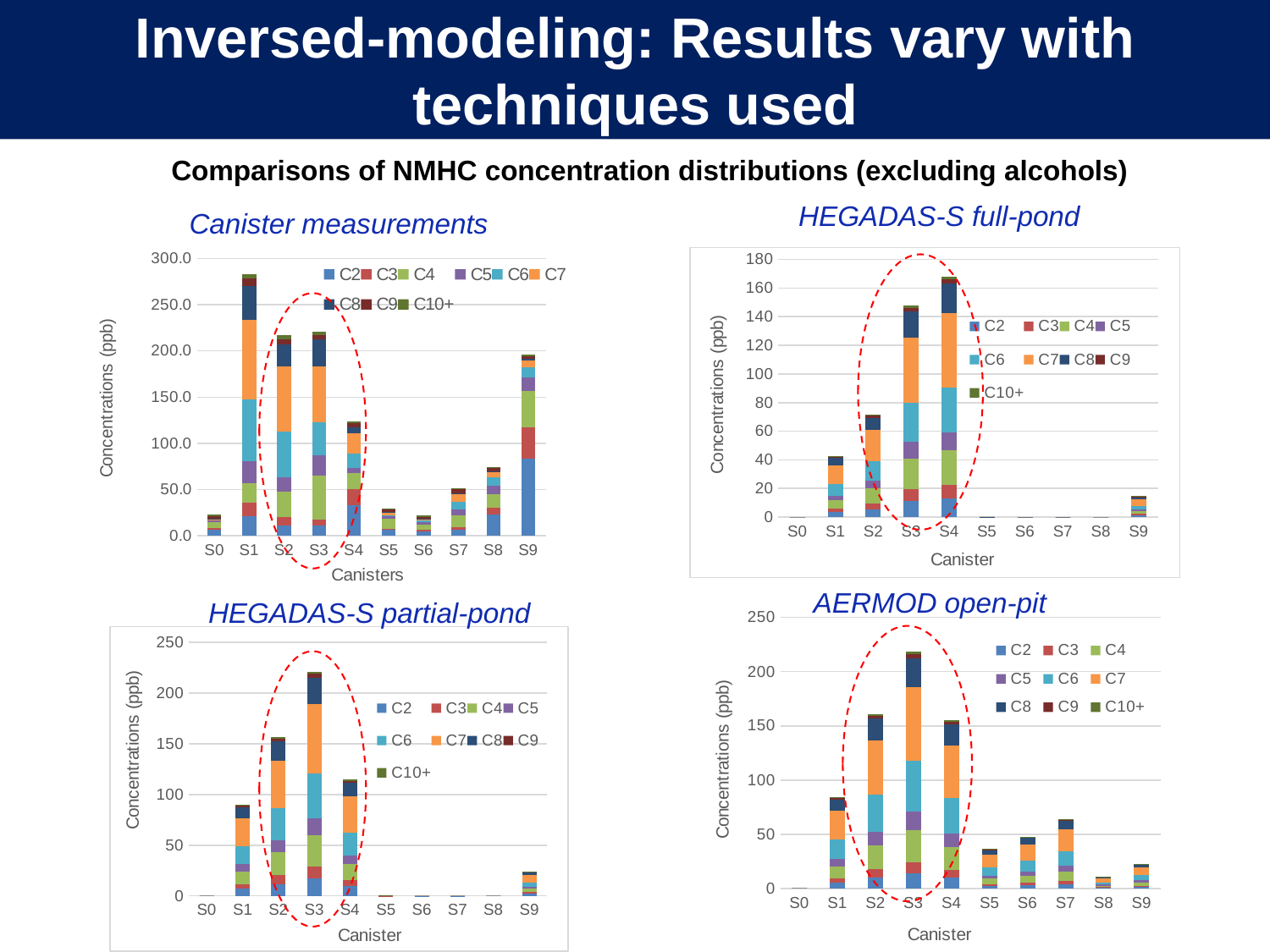
In the Canister measurements chart, what kind of chart is used? Stacked bar chart In the HEGADAS-S full-pond chart, which canister has the highest total concentration? S4 In the Canister measurements chart, how many canister categories are shown on the x axis? 10 In the HEGADAS-S partial-pond chart, is the total value for S1 greater or less than 100? less In the Canister measurements chart, which canister has the highest total concentration? S1 In the HEGADAS-S full-pond chart, is the total value for S9 greater or less than 20? less In the HEGADAS-S partial-pond chart, which canister has the highest total concentration? S3 In the Canister measurements chart, is the total value for S9 greater or less than 150? greater In the HEGADAS-S full-pond chart, how many series does the legend list? 9 In the AERMOD open-pit chart, which has the larger total concentration, S3 or S1? S3 How many charts are shown on the slide? 4